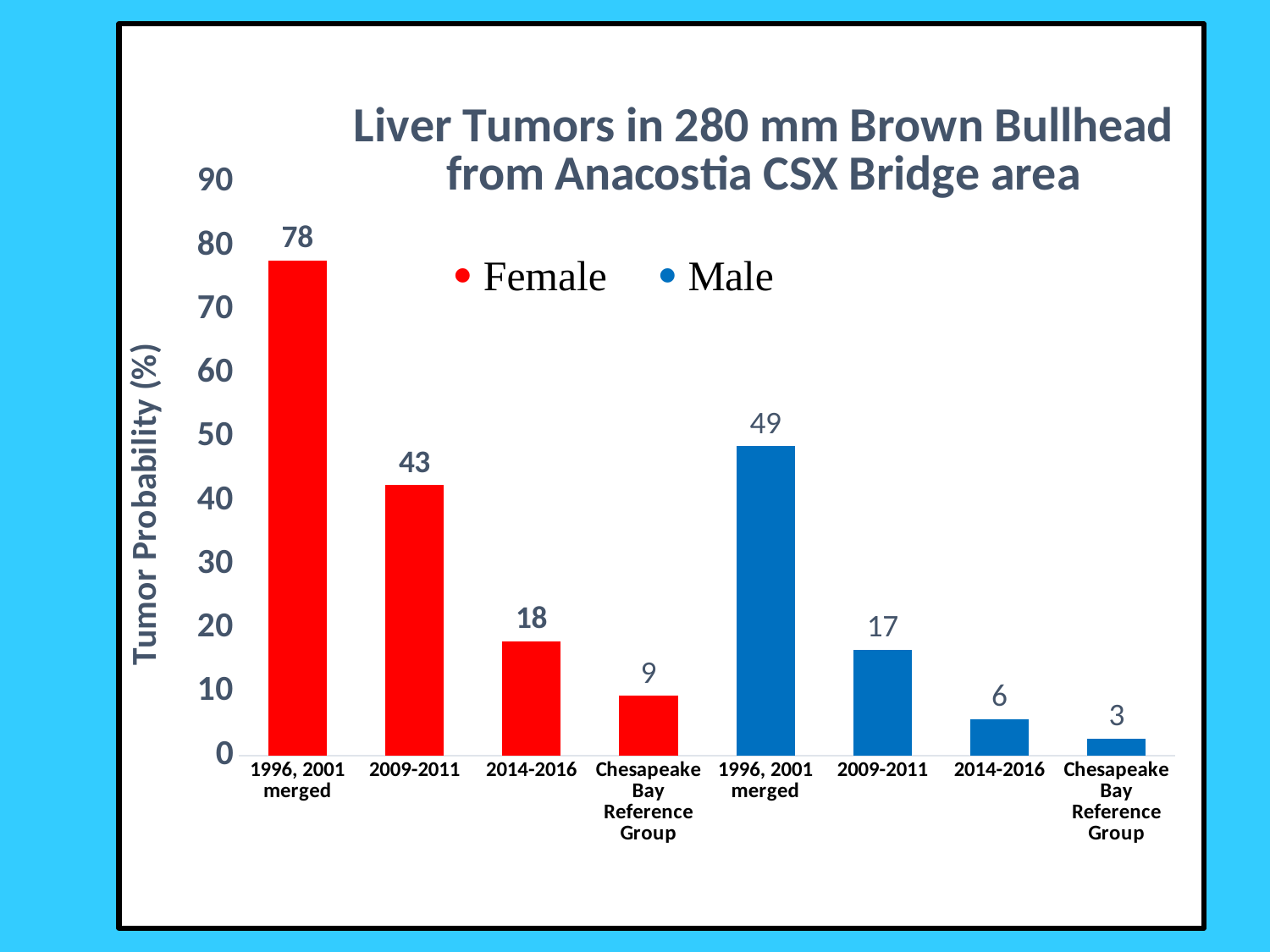
Which is larger, the Female 2014-2016 value or the Male 2009-2011 value? Female 2014-2016 What is the tumor probability for Female fish in the 1996, 2001 merged group? 78 Is the Male value for 1996, 2001 merged greater or less than 40? greater Which bar has the highest tumor probability? Female, 1996, 2001 merged Which bar has the lowest tumor probability? Male, Chesapeake Bay Reference Group What is the tumor probability for Male fish in the Chesapeake Bay Reference Group? 3 What is the difference between the Female 2009-2011 value and the Female 2014-2016 value? 25 How many series does the legend list? 2 What is the tumor probability for Male fish in the 2009-2011 group? 17 How many bars are plotted on the chart? 8 What kind of chart is shown on the slide? Bar chart What is the difference between the Female and Male tumor probabilities for the 1996, 2001 merged group? 29